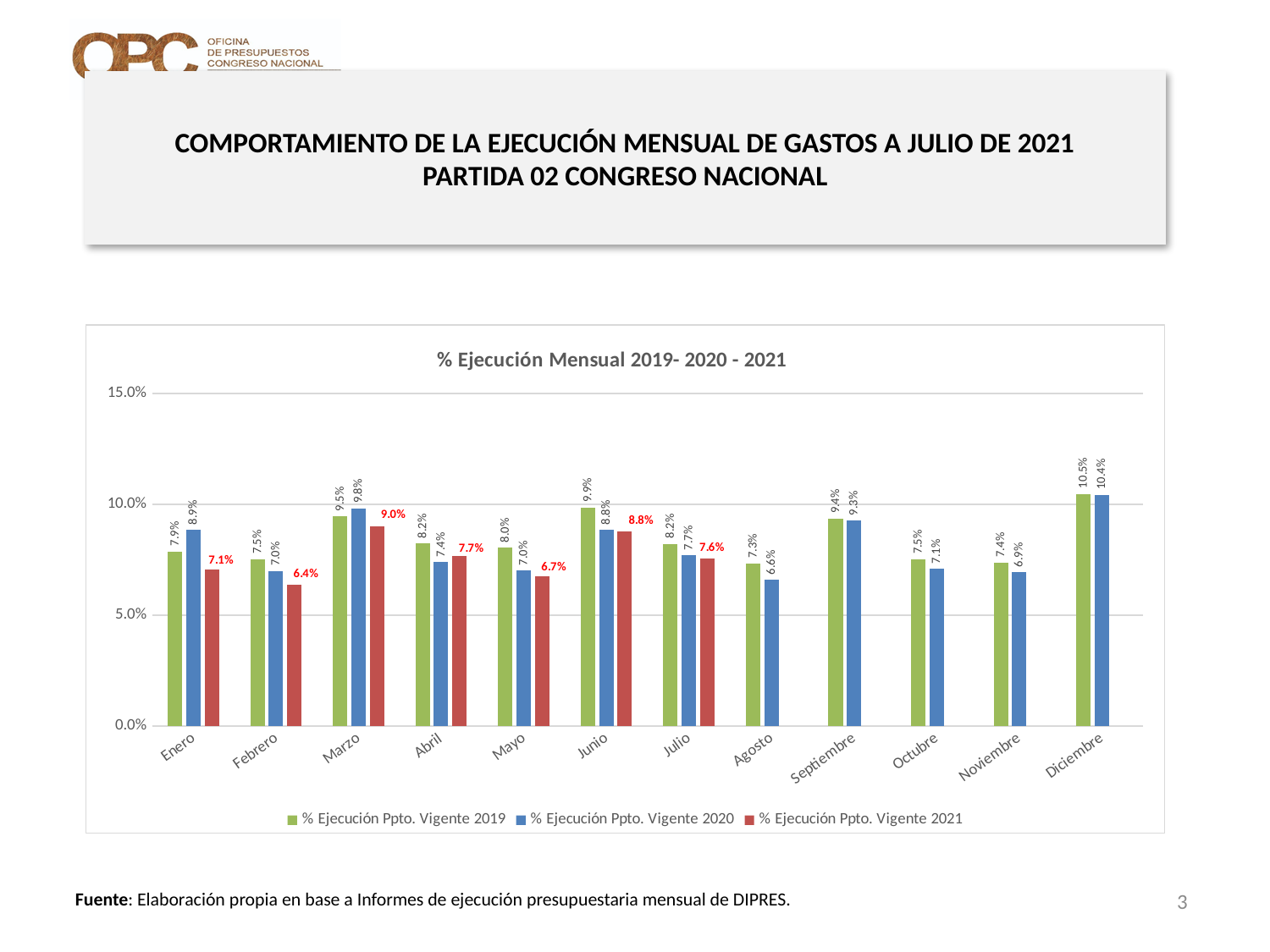
What is the value for % Ejecución Ppto. Vigente 2021 in Marzo? 9.0% What kind of chart is shown on the slide? Bar chart How many months are shown on the x axis? 12 What is the value for % Ejecución Ppto. Vigente 2019 in Diciembre? 10.5% How many series does the legend list? 3 What is the difference between the 2020 and 2021 values in Enero? 1.8 percentage points What is the value for % Ejecución Ppto. Vigente 2020 in Agosto? 6.6% Which month has the lowest value for % Ejecución Ppto. Vigente 2021? Febrero What is the title of the chart? % Ejecución Mensual 2019- 2020 - 2021 Which month has the highest value for % Ejecución Ppto. Vigente 2021? Marzo In Abril, which is larger: the 2020 value or the 2021 value? 2021 (7.7%) Is the value for % Ejecución Ppto. Vigente 2019 in Diciembre greater or less than 10.0%? greater